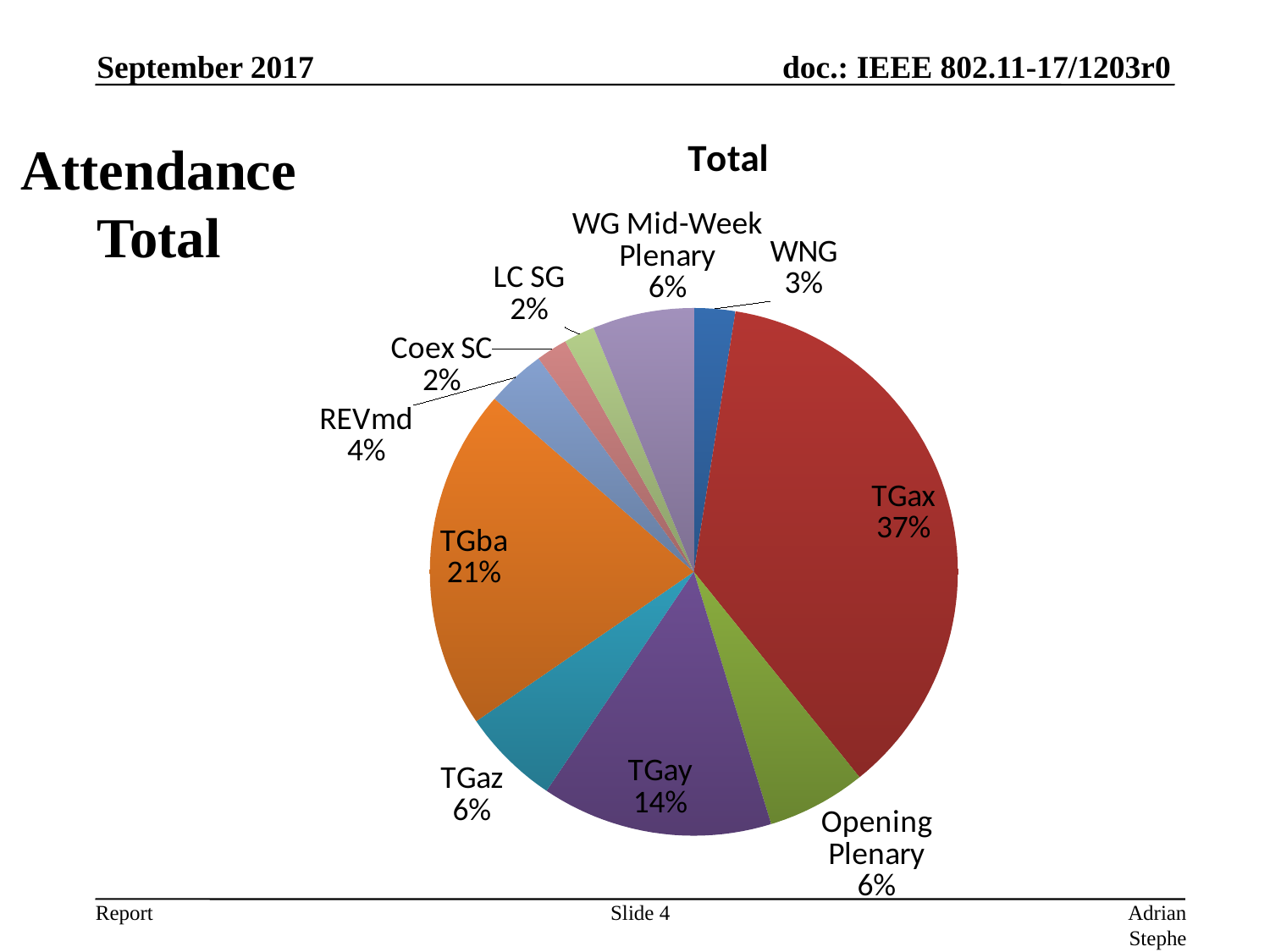
What percentage is shown for REVmd? 4% What percentage is shown for TGba? 21% Which is larger, the share for TGay or the share for TGaz? TGay What percentage is shown for WNG? 3% How many slices does the pie chart have? 10 What percentage is shown for TGay? 14% What is the difference in percentage points between TGax and TGba? 16 What is the title of the chart? Total What is the difference in percentage points between TGay and Opening Plenary? 8 Which slice is the largest in the pie chart? TGax What type of chart is shown on the slide? pie chart What share of the pie does TGax account for? 37%